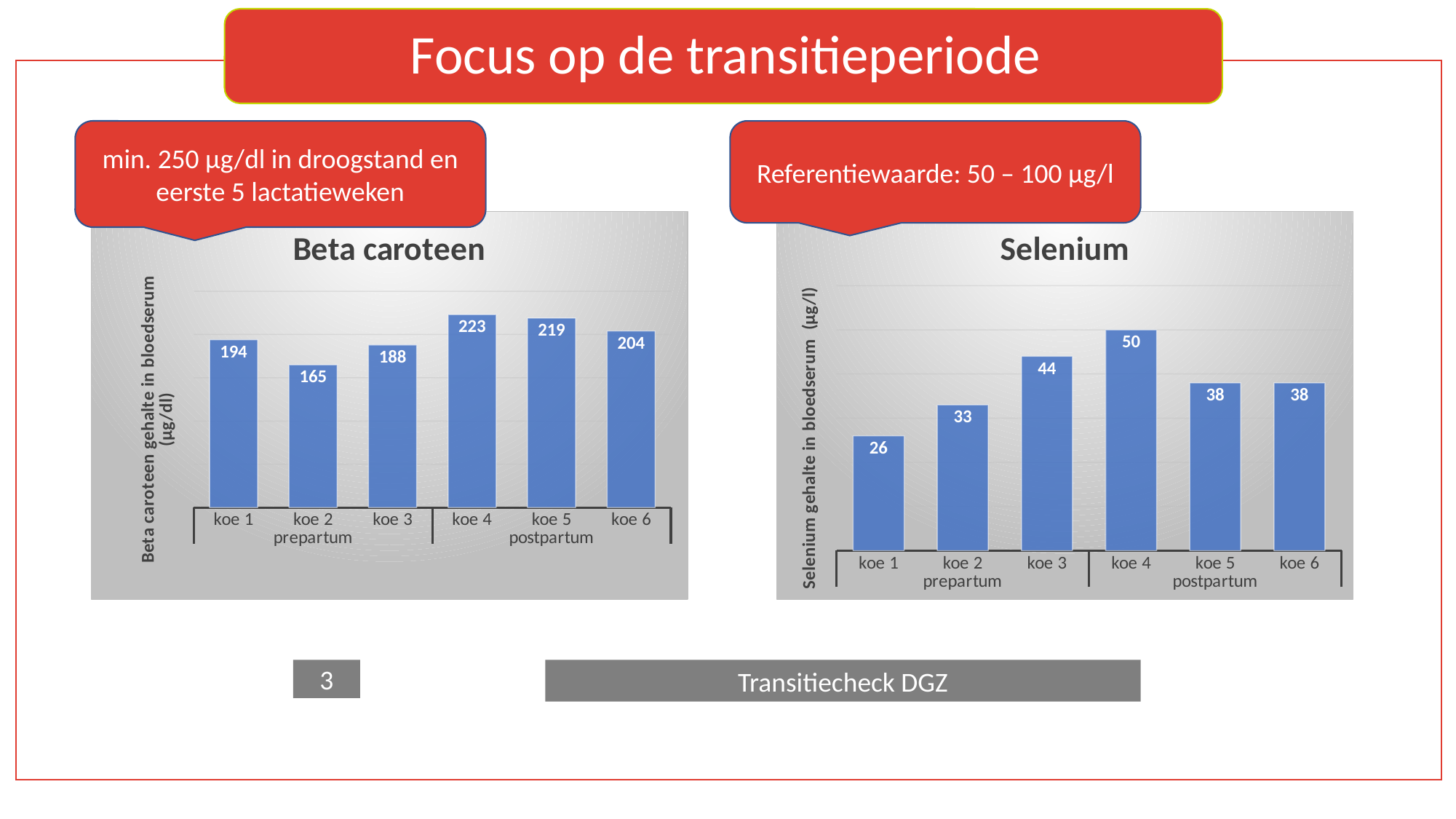
What kind of chart is the Selenium chart? bar chart In the Selenium chart, what is the difference between the values for koe 4 and koe 1? 24 In the Beta caroteen chart, which cow has the lowest value? koe 2 In the Selenium chart, which is larger, the value for koe 2 or the value for koe 5? koe 5 In the Selenium chart, which cow has the lowest value? koe 1 In the Beta caroteen chart, how many cows are plotted? 6 In the Selenium chart, what is the value for koe 3? 44 In the Beta caroteen chart, what is the value for koe 2? 165 In the Selenium chart, which cow has the highest value? koe 4 In the Beta caroteen chart, what is the difference between the values for koe 4 and koe 1? 29 In the Beta caroteen chart, which cow has the highest value? koe 4 In the Selenium chart, do the values rise or fall from koe 1 to koe 4? rise